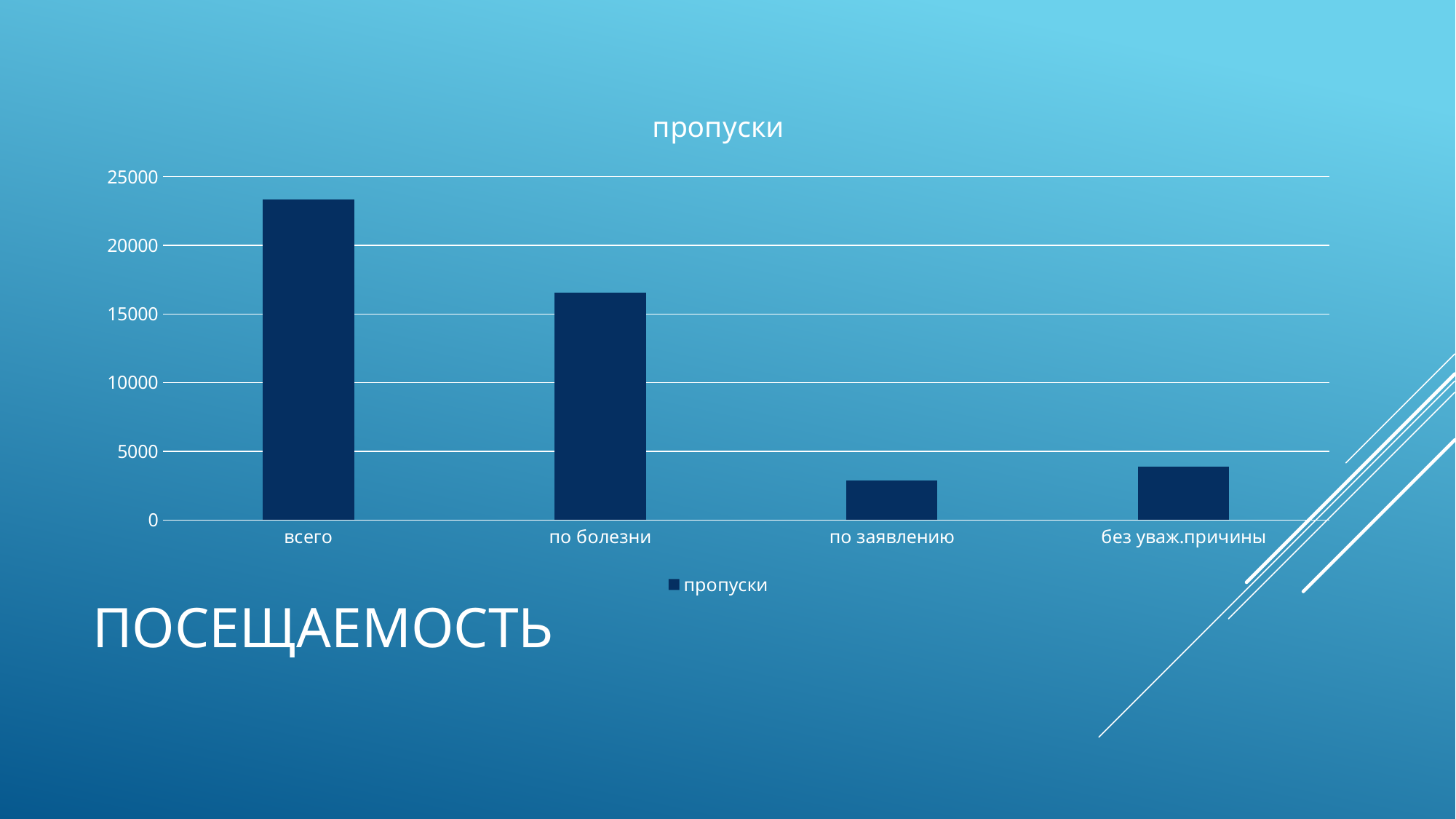
What is the name of the series shown in the chart legend? пропуски What kind of chart is shown on the slide? bar chart Which category has the lowest value in the chart? по заявлению Is the value for без уваж.причины greater or less than 5000? less Is the value for по заявлению greater or less than 5000? less What is the title of the chart? пропуски Which category has the highest value in the chart? всего Is the value for по болезни greater or less than 15000? greater How many series does the chart legend list? 1 How many categories are shown on the x axis of the chart? 4 Which is larger, the value for по болезни or the value for без уваж.причины? по болезни